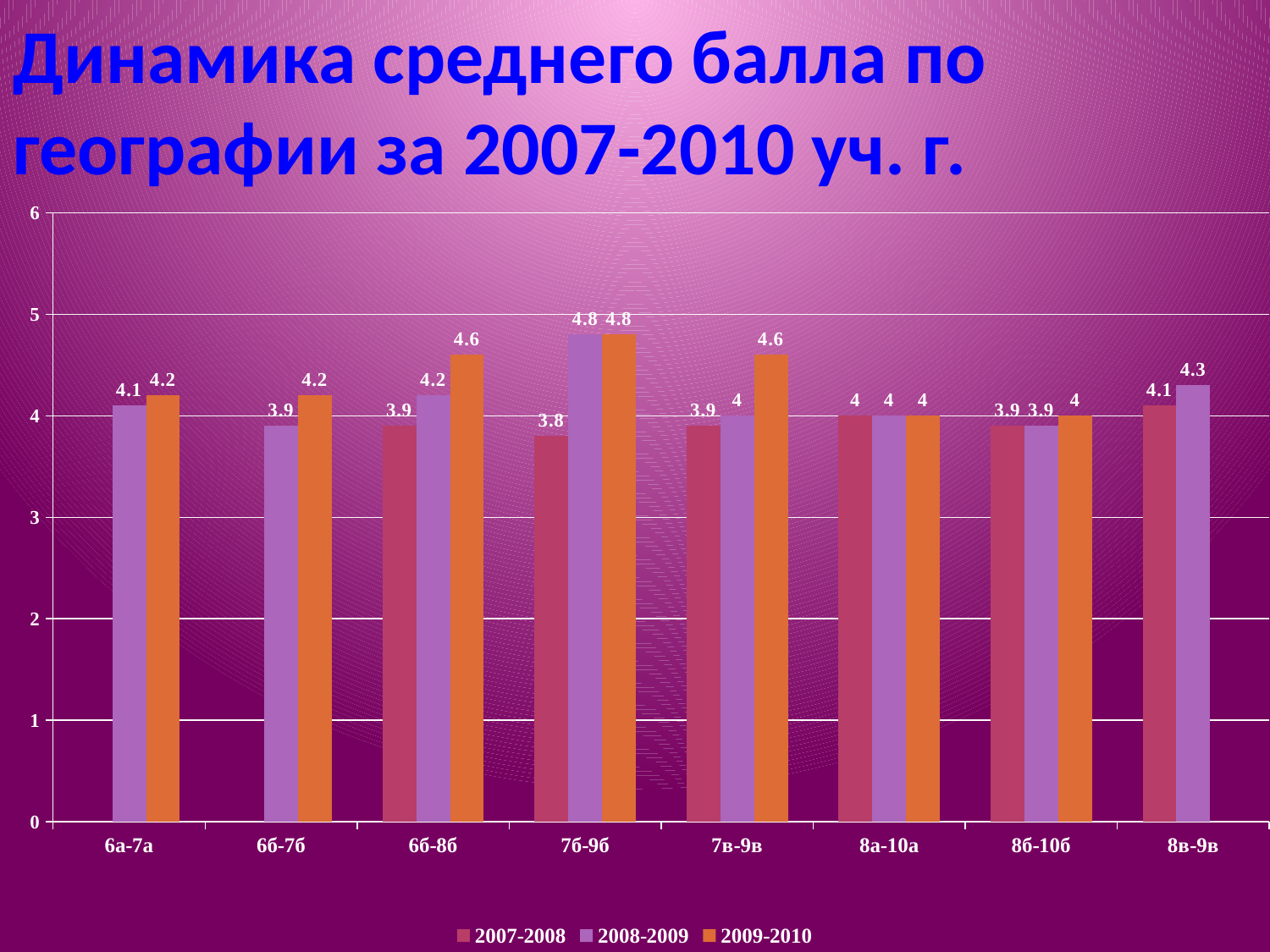
Do the values for 6б-8б rise or fall from 2007-2008 to 2009-2010? Rise What is the value for 8в-9в in the 2008-2009 series? 4.3 What is the value for 6б-8б in the 2007-2008 series? 3.9 Which series is shown in orange in the legend? 2009-2010 Which category has the highest value in the 2008-2009 series? 7б-9б What kind of chart is shown on the slide? Bar chart What is the difference between the 2009-2010 and 2007-2008 values for 7б-9б? 1 What is the value for 7б-9б in the 2009-2010 series? 4.8 How many categories are shown on the x axis? 8 Which is larger for 7в-9в: the 2008-2009 value or the 2009-2010 value? 2009-2010 How many series does the legend list? 3 Which category has the lowest value in the 2007-2008 series? 7б-9б